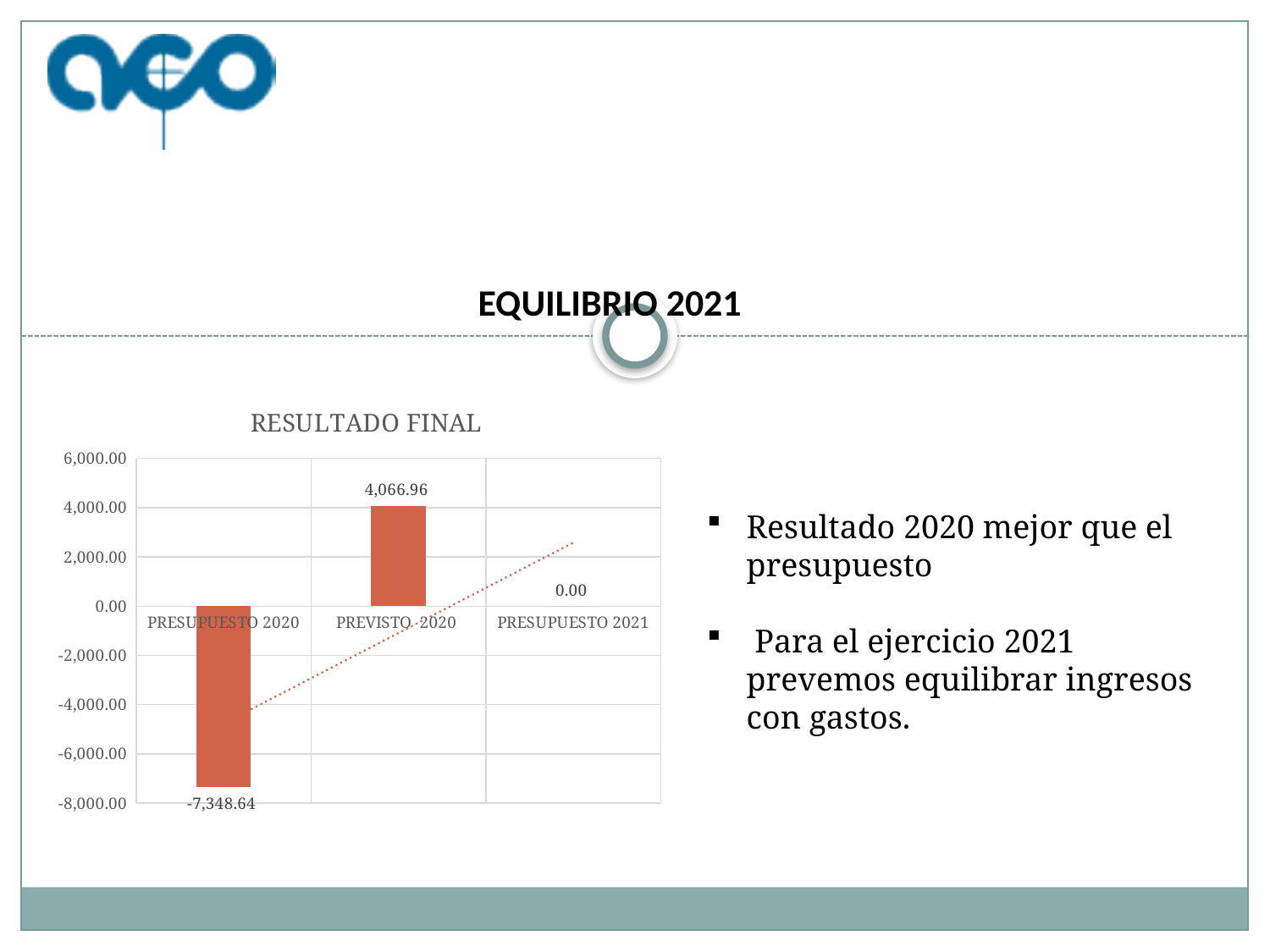
Which is larger, the value for PREVISTO 2020 or the value for PRESUPUESTO 2021? PREVISTO 2020 How many categories are shown on the x axis of the chart? 3 What is the value for PRESUPUESTO 2020? -7,348.64 What is the title of the chart? RESULTADO FINAL Is the value for PRESUPUESTO 2020 greater or less than -6,000.00? less What is the difference between the values for PREVISTO 2020 and PRESUPUESTO 2020? 11,415.60 Which category has the lowest value? PRESUPUESTO 2020 Which category has the highest value? PREVISTO 2020 What is the value for PRESUPUESTO 2021? 0.00 What is the value for PREVISTO 2020? 4,066.96 What colour are the bars in the chart? orange-red What type of chart is shown on the slide? bar chart